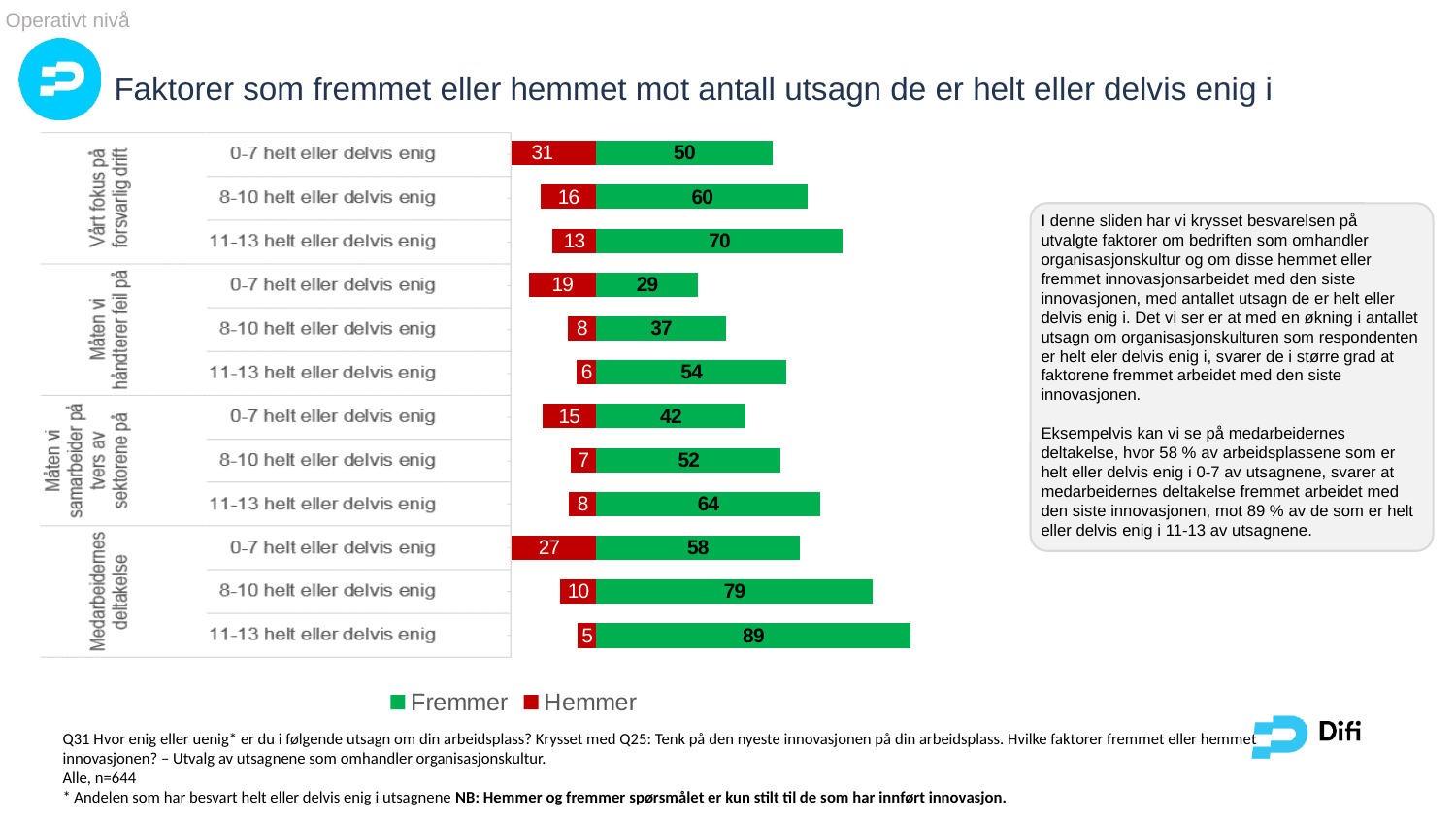
Which colour represents the Hemmer series in the chart? Red Within each factor group, does the Fremmer value rise or fall as the number of agreed statements increases from 0-7 to 11-13? Rises Which is larger: the Hemmer value for '0-7 helt eller delvis enig' under Vårt fokus på forsvarlig drift or under Medarbeidernes deltakelse? Vårt fokus på forsvarlig drift (31) What is the Fremmer value for '8-10 helt eller delvis enig' under Måten vi håndterer feil på? 37 What is the difference between the Fremmer values for '11-13' and '0-7 helt eller delvis enig' under Medarbeidernes deltakelse? 31 How many bars (category rows) are plotted in the chart? 12 What is the Hemmer value for '0-7 helt eller delvis enig' under Vårt fokus på forsvarlig drift? 31 Which category has the lowest Fremmer value? 0-7 helt eller delvis enig (Måten vi håndterer feil på) Which category has the highest Fremmer value? 11-13 helt eller delvis enig (Medarbeidernes deltakelse) What kind of chart is shown on the slide? Bar chart How many series does the legend list? 2 What is the Fremmer value for '11-13 helt eller delvis enig' under Medarbeidernes deltakelse? 89